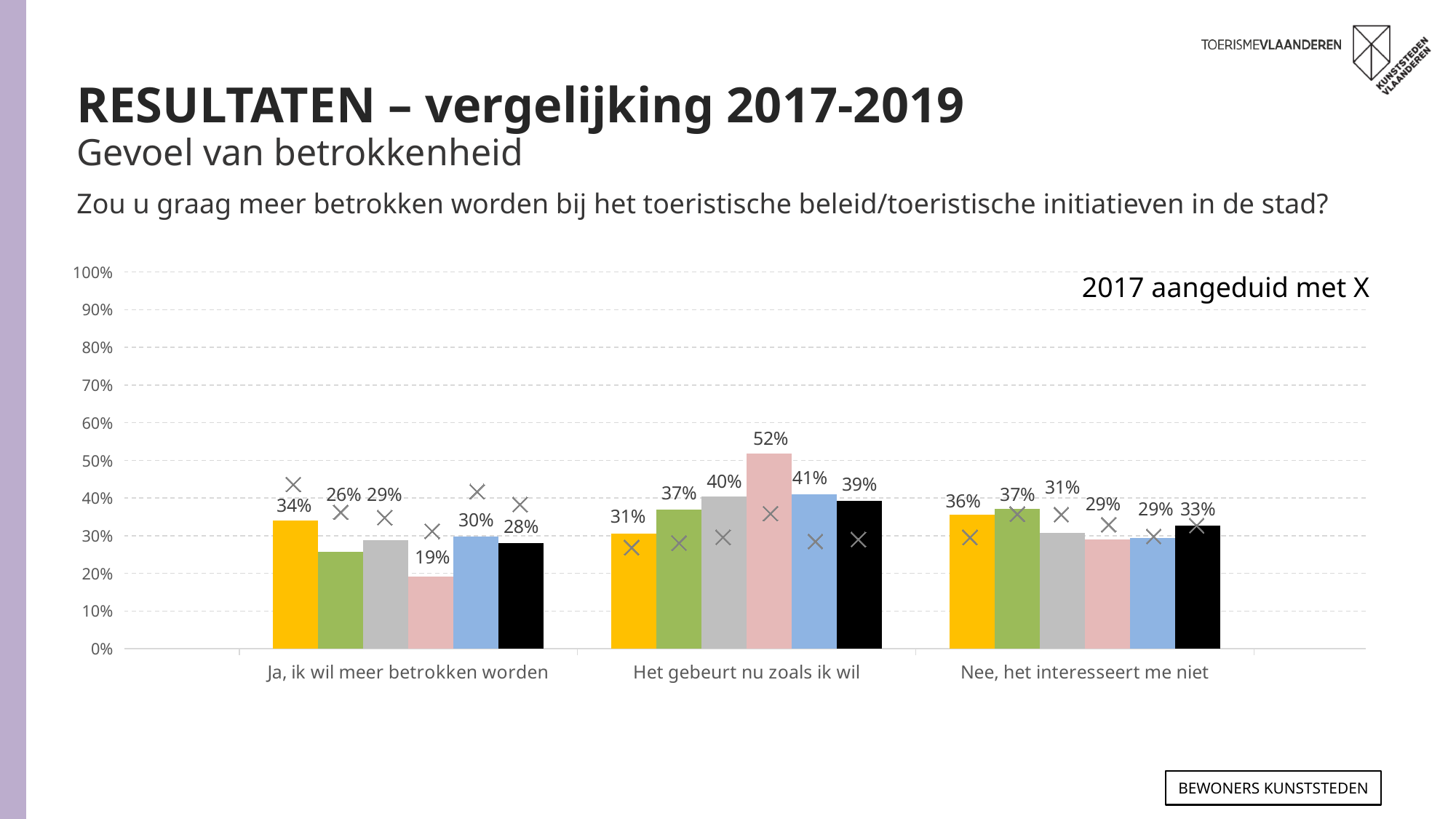
According to the note on the chart, what do the X markers indicate? The 2017 values How many bars are plotted for each answer category? 6 What is the value of the yellow bar for 'Ja, ik wil meer betrokken worden'? 34% What is the lowest labelled value in the chart? 19% What is the difference between the pink bar for 'Het gebeurt nu zoals ik wil' (52%) and the pink bar for 'Ja, ik wil meer betrokken worden' (19%)? 33 percentage points Is the 2017 X marker above the yellow bar for 'Ja, ik wil meer betrokken worden' greater or less than 40%? greater What is the value of the pink bar for 'Het gebeurt nu zoals ik wil'? 52% What is the value of the black bar for 'Nee, het interesseert me niet'? 33% Which is larger: the green bar for 'Nee, het interesseert me niet' or the green bar for 'Ja, ik wil meer betrokken worden'? Nee, het interesseert me niet What kind of chart is shown on the slide? Bar chart How many answer categories are shown along the x axis of the chart? 3 What is the highest labelled value in the chart? 52%